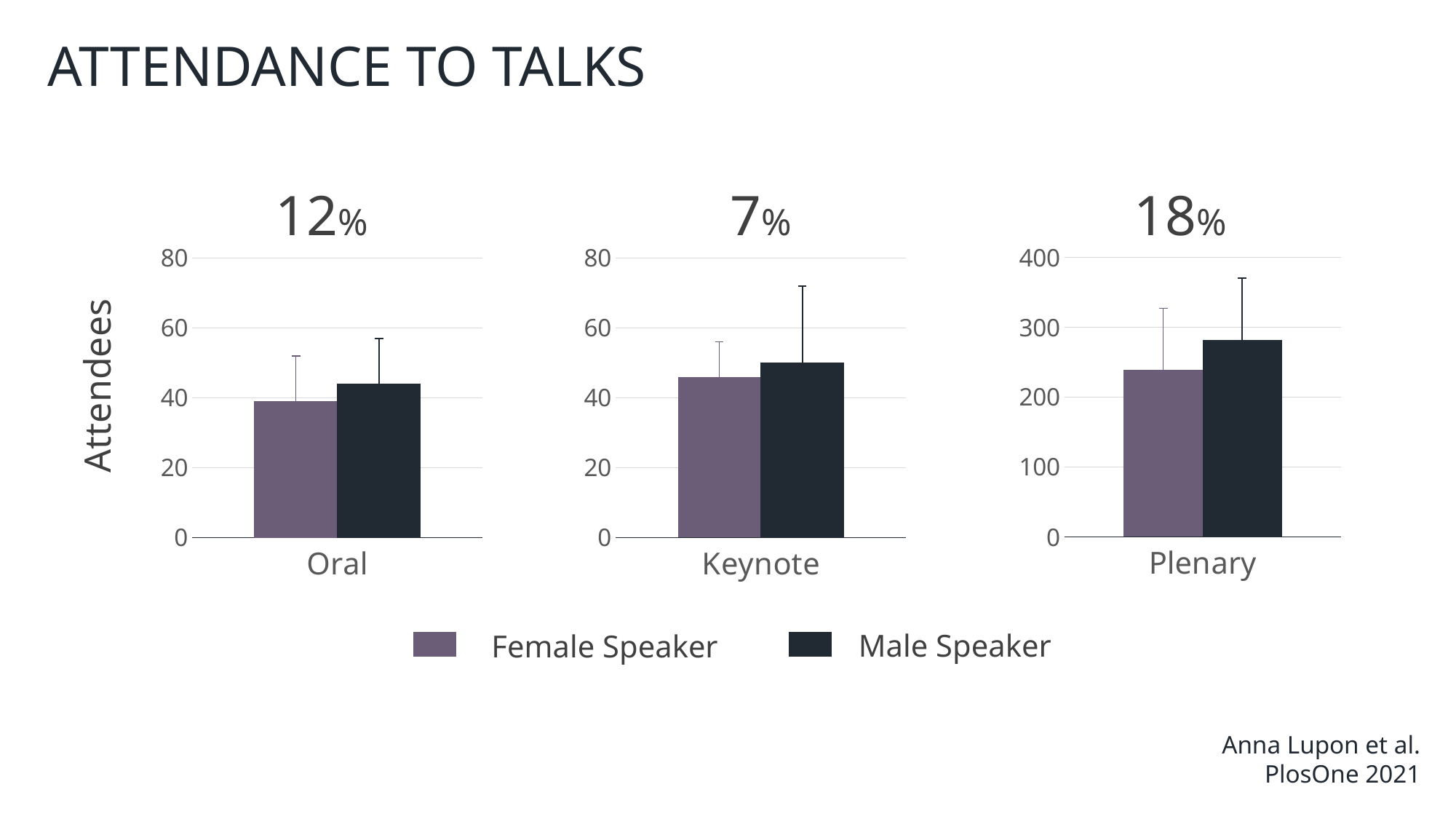
In the Keynote chart, is the value for Male Speaker greater or less than 60? less How many series does the legend list? 2 What percentage is printed above the Keynote chart? 7% How many separate bar charts are shown on the slide? 3 In the Plenary chart, is the value for Male Speaker greater or less than 300? less In the Keynote chart, is the value for Female Speaker greater or less than 40? greater In the Oral chart, which is larger, the Female Speaker bar or the Male Speaker bar? Male Speaker In the Plenary chart, which is larger, the Female Speaker bar or the Male Speaker bar? Male Speaker What is the label on the vertical axis of the charts? Attendees What kind of chart is used for the Oral talks panel? bar chart